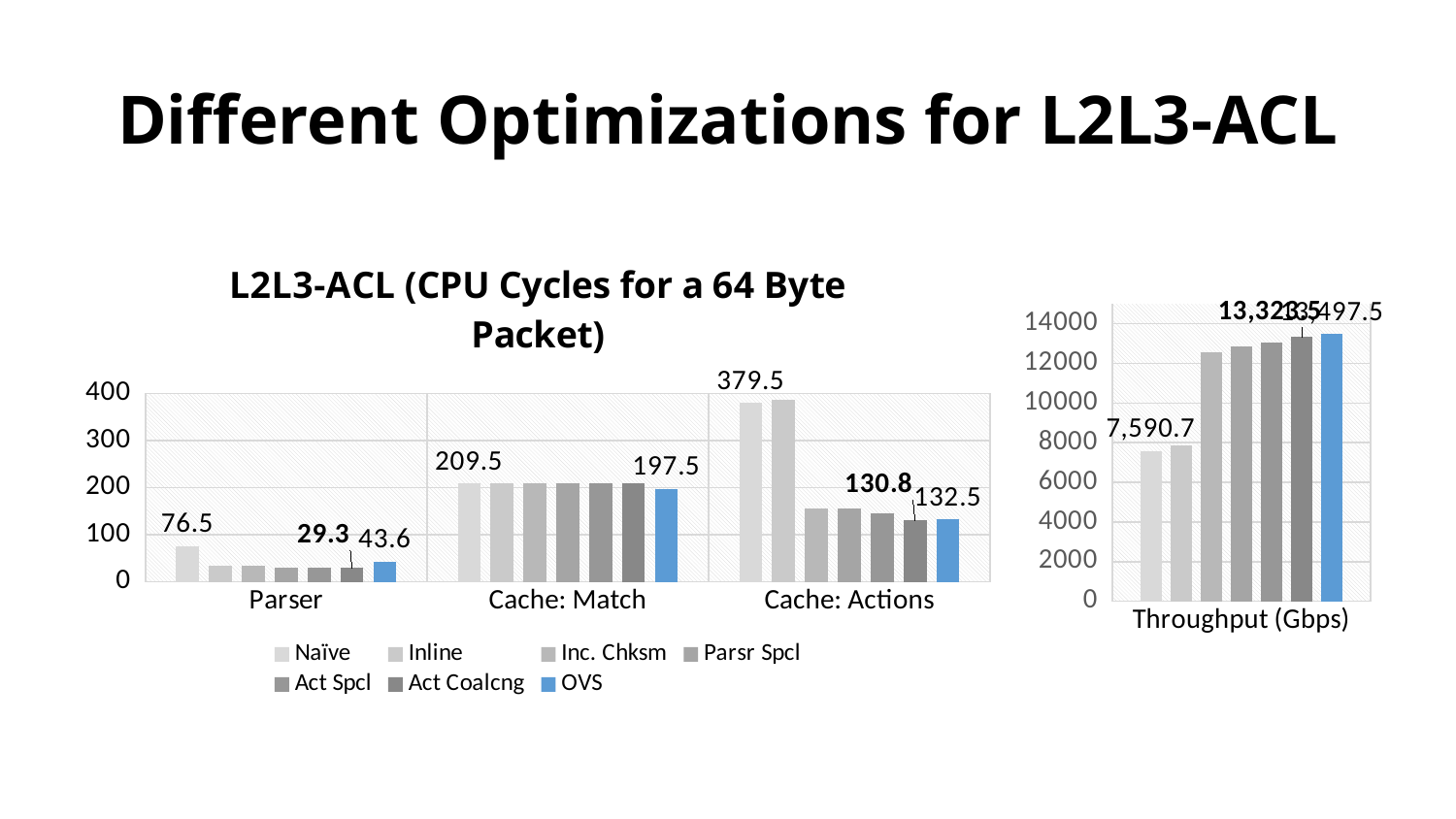
In the Throughput (Gbps) chart on the right, what is the Naïve throughput value? 7,590.7 In the L2L3-ACL (CPU Cycles for a 64 Byte Packet) chart, what is the Naïve value for Parser? 76.5 In the L2L3-ACL (CPU Cycles for a 64 Byte Packet) chart, what is the Naïve value for Cache: Actions? 379.5 In the L2L3-ACL (CPU Cycles for a 64 Byte Packet) chart, what is the OVS value for Cache: Match? 197.5 In the L2L3-ACL (CPU Cycles for a 64 Byte Packet) chart, which is larger for Parser: Act Coalcng or OVS? OVS How many series does the legend of the L2L3-ACL (CPU Cycles for a 64 Byte Packet) chart list? 7 In the L2L3-ACL (CPU Cycles for a 64 Byte Packet) chart, what is the difference between the Naïve and OVS values for Parser? 32.9 In the L2L3-ACL (CPU Cycles for a 64 Byte Packet) chart, which category has the highest Naïve value? Cache: Actions In the L2L3-ACL (CPU Cycles for a 64 Byte Packet) chart, what is the difference between the Naïve and OVS values for Cache: Match? 12 In the L2L3-ACL (CPU Cycles for a 64 Byte Packet) chart, what is the Act Coalcng value for Cache: Actions? 130.8 In the Throughput (Gbps) chart on the right, is the OVS value greater or less than 12000? greater How many categories are shown on the x axis of the L2L3-ACL (CPU Cycles for a 64 Byte Packet) chart? 3